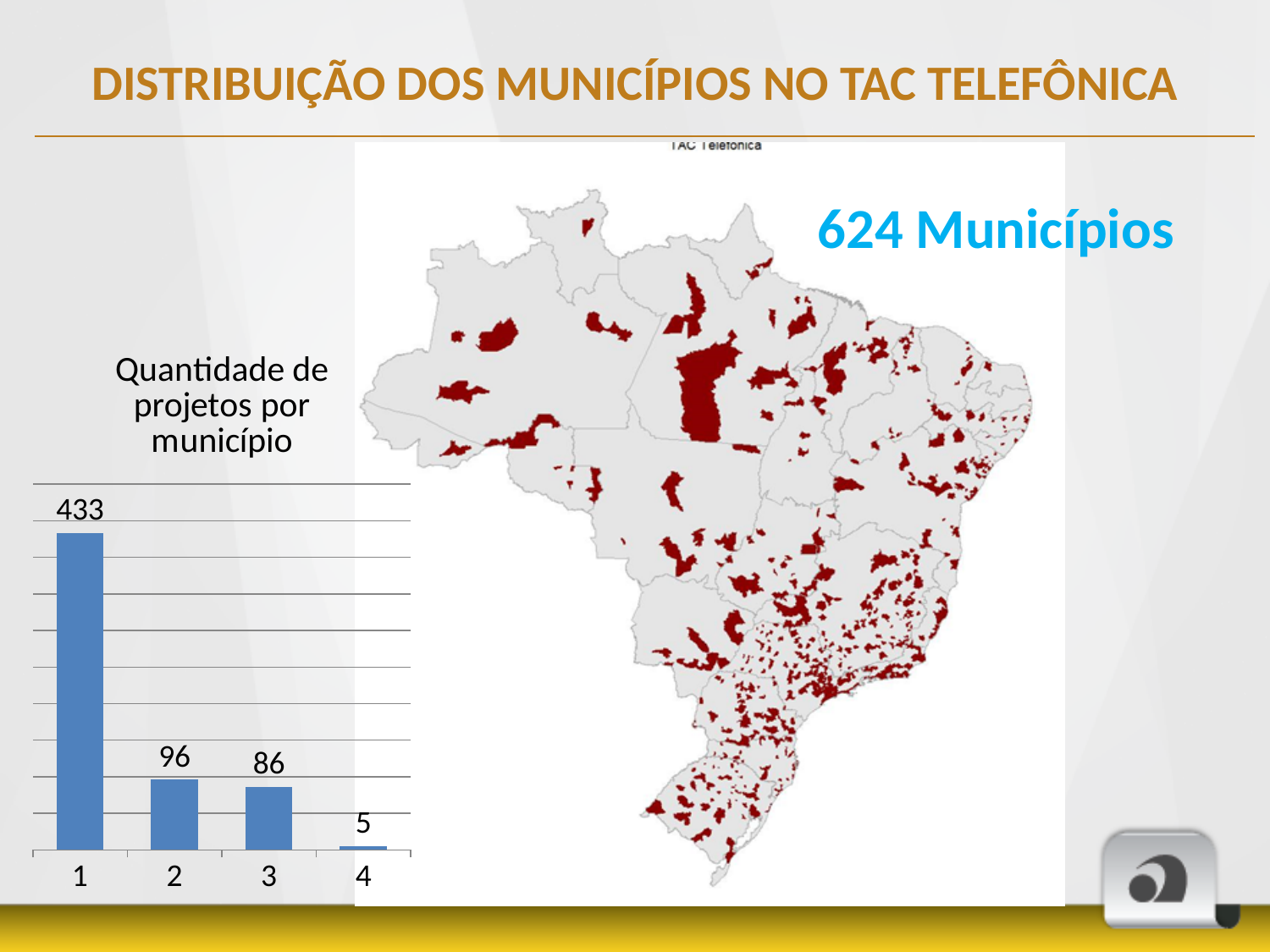
What is the value for category 1 in the 'Quantidade de projetos por município' chart? 433 What is the value for category 2 in the 'Quantidade de projetos por município' chart? 96 What is the difference between the values for category 1 and category 2 in the 'Quantidade de projetos por município' chart? 337 Do the values rise or fall from category 1 to category 4 in the 'Quantidade de projetos por município' chart? fall What is the value for category 4 in the 'Quantidade de projetos por município' chart? 5 What kind of chart is the 'Quantidade de projetos por município' chart? bar chart How many categories are shown in the 'Quantidade de projetos por município' chart? 4 What is the difference between the values for category 2 and category 3 in the 'Quantidade de projetos por município' chart? 10 Which category has the lowest value in the 'Quantidade de projetos por município' chart? 4 Which is larger in the 'Quantidade de projetos por município' chart, the value for category 2 or category 3? 2 What is the value for category 3 in the 'Quantidade de projetos por município' chart? 86 Which category has the highest value in the 'Quantidade de projetos por município' chart? 1